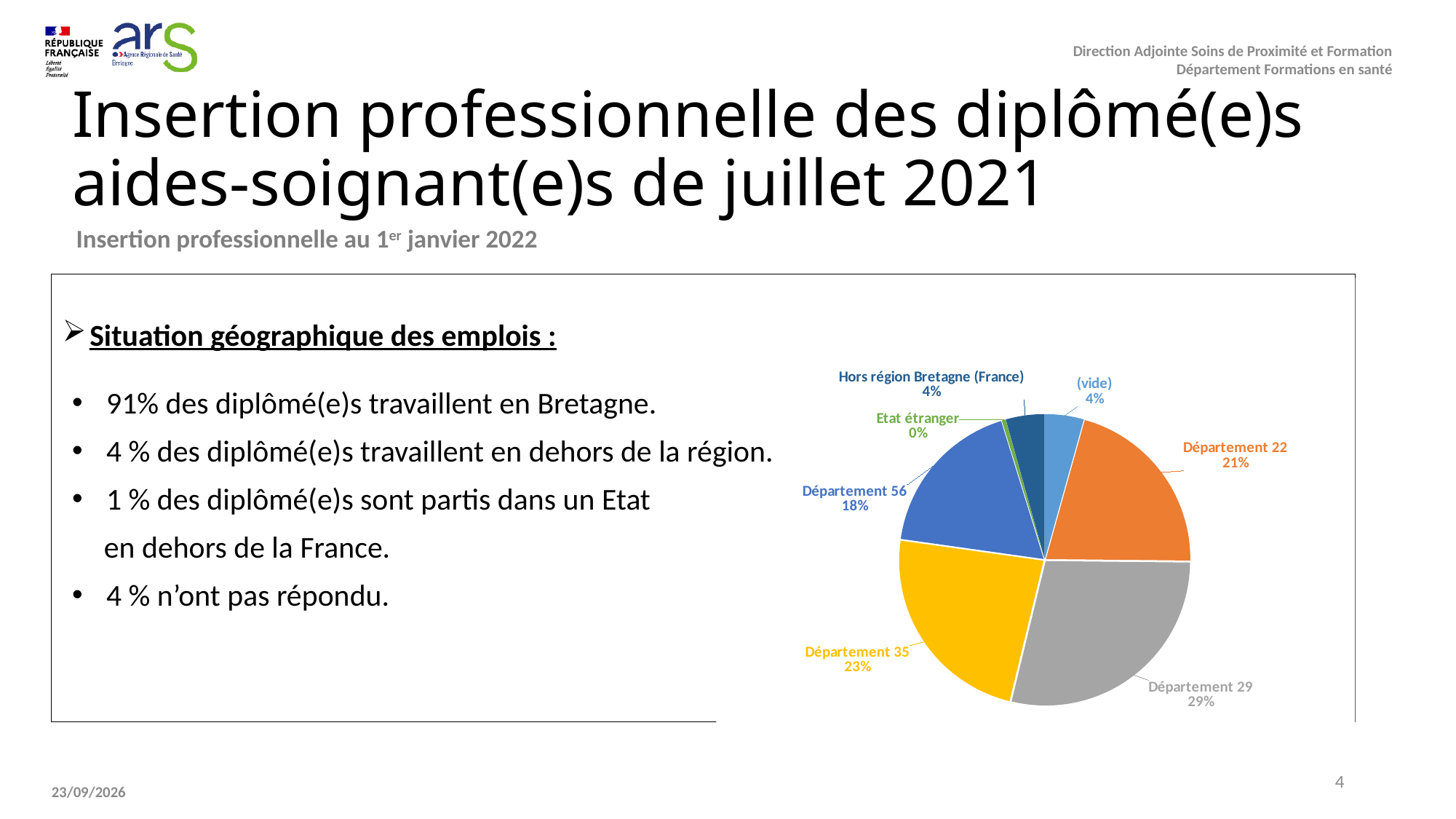
What share of the pie does Département 56 represent? 18% Which slice of the pie chart is the smallest? Etat étranger What share of the pie does Département 29 represent? 29% What share of the pie is labelled Hors région Bretagne (France)? 4% What is the difference in percentage points between Département 29 and Département 56? 11 Which is larger, the share for Département 35 or the share for Département 22? Département 35 What share of the pie does Département 22 represent? 21% What share of the pie is labelled Etat étranger? 0% Which slice of the pie chart is the largest? Département 29 What share of the pie does Département 35 represent? 23% How many slices does the pie chart have? 7 What kind of chart is shown on the slide? pie chart